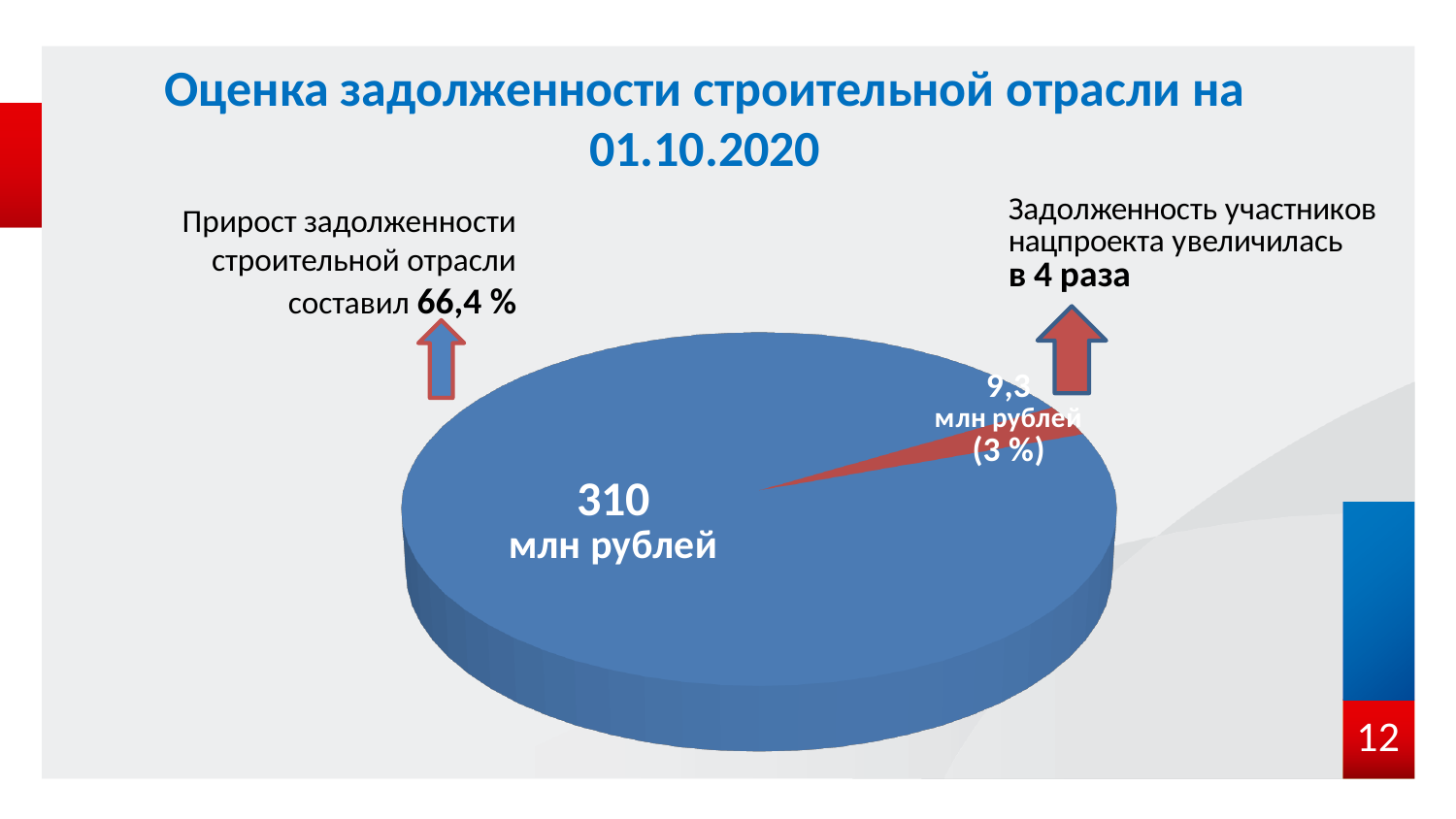
What colour is the slice labelled 9,3 млн рублей (3 %)? Red Which slice of the pie chart is larger, the blue one or the red one? The blue one What is the title of the slide containing the pie chart? Оценка задолженности строительной отрасли на 01.10.2020 What kind of chart is shown on the slide? Pie chart What is the difference in млн рублей between the blue slice (310) and the red slice (9,3)? 300,7 млн рублей What value is printed on the large blue slice of the pie chart? 310 млн рублей How many slices does the pie chart have? 2 What share of the pie does the small red slice represent, as printed on the chart? 3 % Which slice of the pie chart is the smallest? The red slice (9,3 млн рублей) What value is printed on the small red slice of the pie chart? 9,3 млн рублей